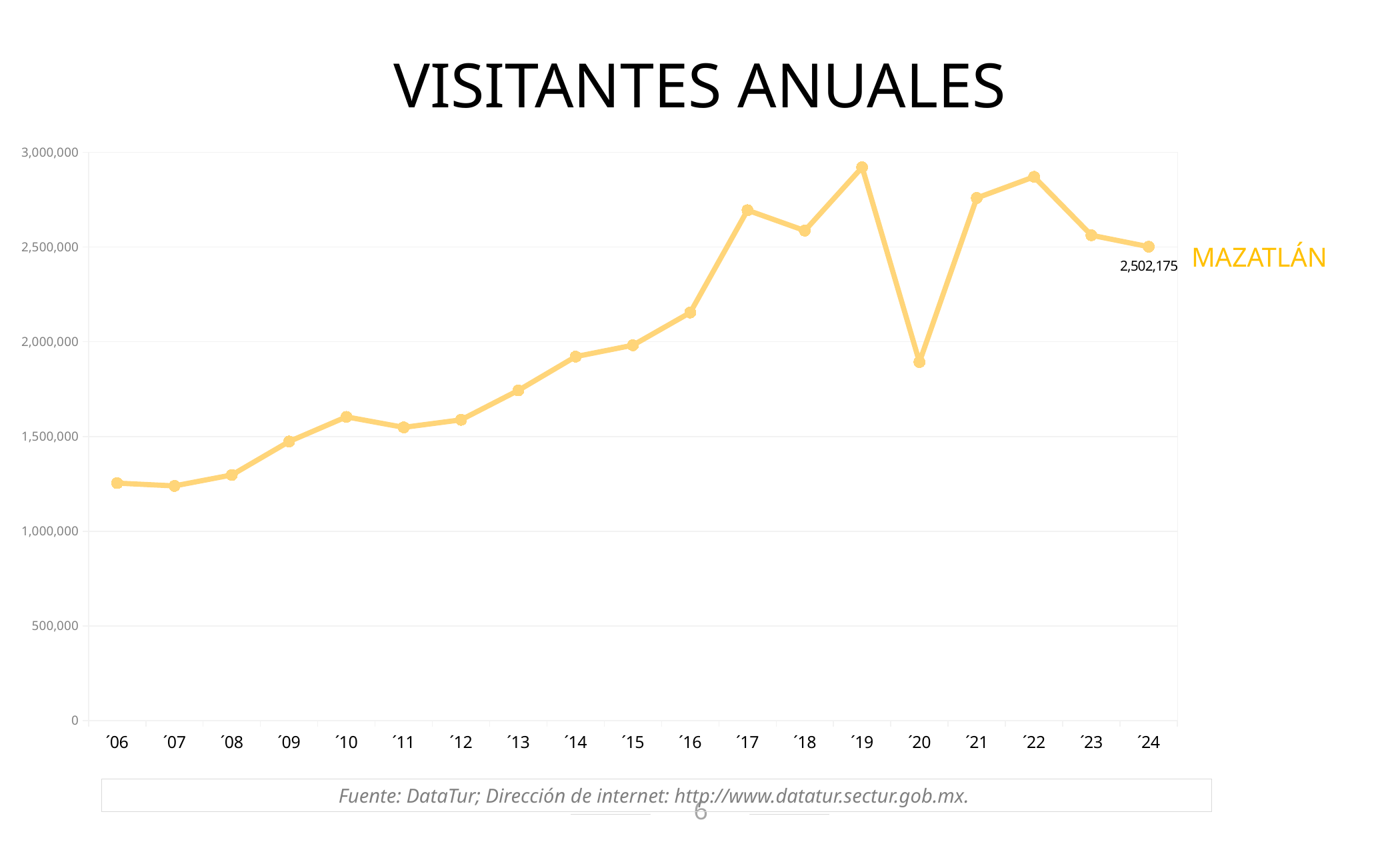
What kind of chart is shown on the slide? Line chart Is the value for ´17 greater or less than 2,500,000? greater Which is larger, the value for ´19 or the value for ´20? ´19 What is the value for ´24 on the chart? 2,502,175 Is the value for ´20 greater or less than 2,000,000? less What is the title of the chart? VISITANTES ANUALES Is the value for ´06 greater or less than 1,500,000? less Do the values rise or fall from ´06 to ´10? Rise What is the name of the series plotted on the chart? MAZATLÁN How many data points are plotted on the chart? 19 How many series does the chart show? 1 Which year has the highest number of visitors? ´19